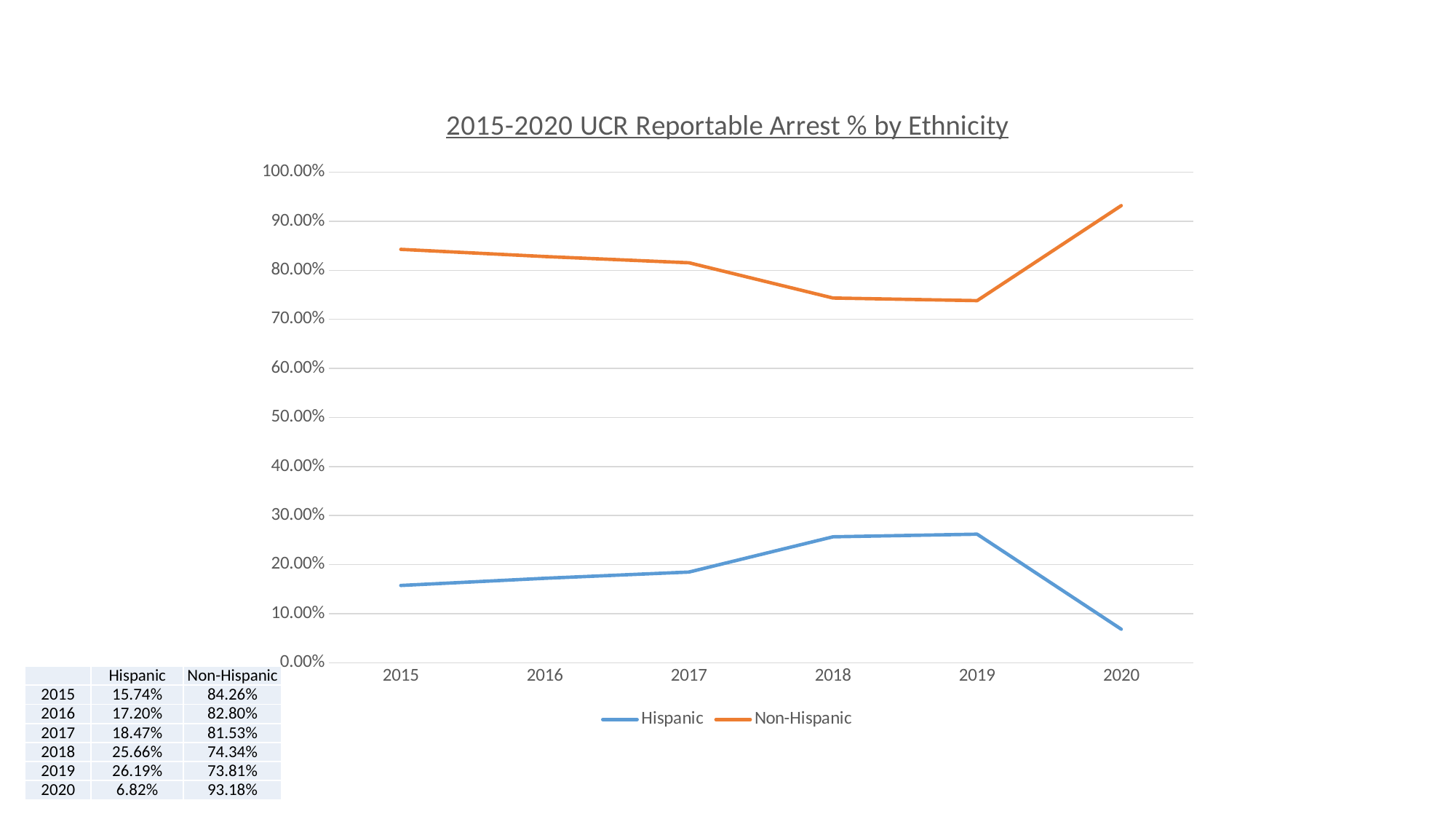
In which year is the Hispanic percentage highest? 2019 Which series has the larger value in 2017, Hispanic or Non-Hispanic? Non-Hispanic What is the difference between the Non-Hispanic and Hispanic percentages in 2015? 68.52% What type of chart is shown on the slide? line chart What is the Non-Hispanic arrest percentage for 2020? 93.18% Is the Non-Hispanic value for 2020 greater or less than 90.00%? greater What is the title of the chart? 2015-2020 UCR Reportable Arrest % by Ethnicity What is the Hispanic arrest percentage for 2018? 25.66% Does the Hispanic line rise or fall from 2019 to 2020? fall How many years are plotted along the x axis? 6 How many series does the legend list? 2 In which year is the Non-Hispanic percentage lowest? 2019